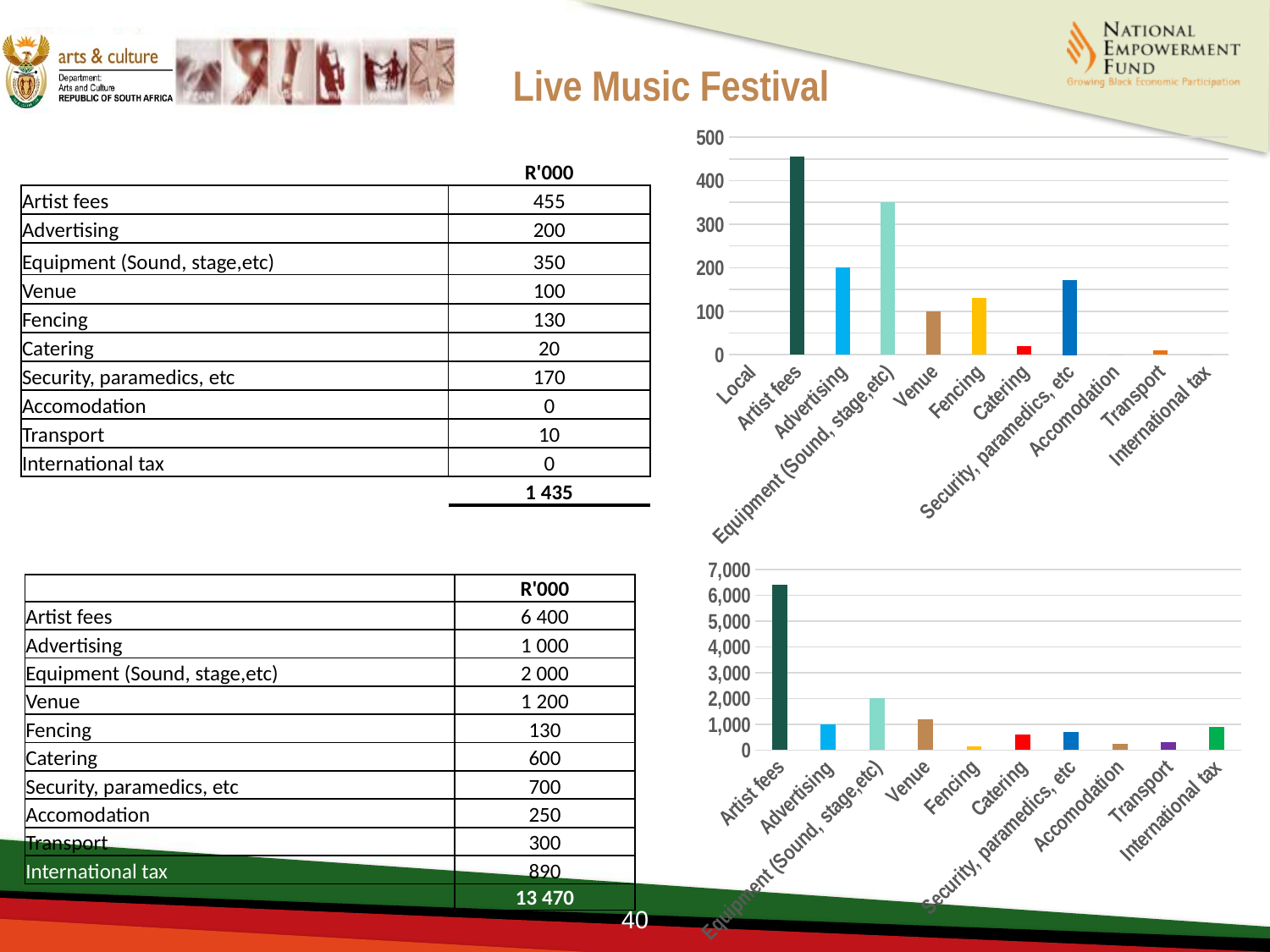
In the top chart, is the value for Artist fees greater or less than 400? greater In the bottom chart, which is larger, Equipment (Sound, stage,etc) or Venue? Equipment (Sound, stage,etc) In the bottom chart, is the value for Artist fees greater or less than 6,000? greater In the top chart, what is the value for Venue? 100 In the top chart, what is the value for Advertising? 200 How many categories are shown on the x axis of the bottom chart? 10 In the bottom chart, which category has the highest value? Artist fees In the bottom chart, what is the difference between Equipment (Sound, stage,etc) and Advertising? 1,000 What kind of chart is the top chart on the slide? bar chart In the top chart, which category has the highest value? Artist fees In the top chart, is the value for Catering greater or less than 100? less In the bottom chart, what is the value for Equipment (Sound, stage,etc)? 2,000